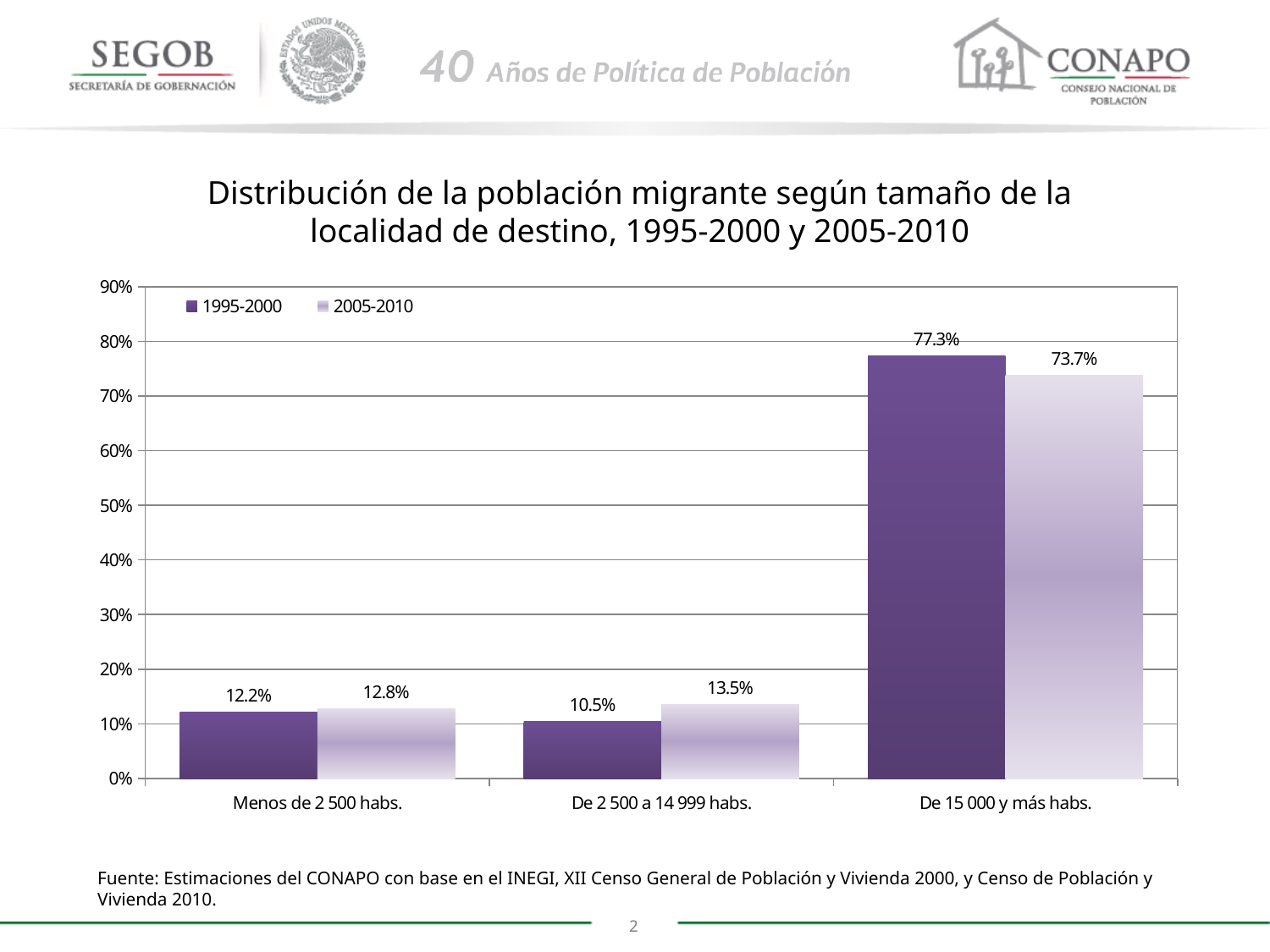
For 'De 2 500 a 14 999 habs.', which series has the larger value, 1995-2000 or 2005-2010? 2005-2010 What is the difference between the 1995-2000 and 2005-2010 values for 'De 15 000 y más habs.'? 3.6% Which category has the lowest value in the 1995-2000 series? De 2 500 a 14 999 habs. What is the value for 'De 2 500 a 14 999 habs.' in the 1995-2000 series? 10.5% What are the two series named in the legend? 1995-2000 and 2005-2010 What kind of chart is shown on the slide? bar chart What is the value for 'Menos de 2 500 habs.' in the 2005-2010 series? 12.8% What is the value for 'De 15 000 y más habs.' in the 1995-2000 series? 77.3% Is the 2005-2010 value for 'De 15 000 y más habs.' greater or less than 70%? greater How many series does the legend list? 2 How many categories are shown on the x axis? 3 Which category has the highest value in the 2005-2010 series? De 15 000 y más habs.